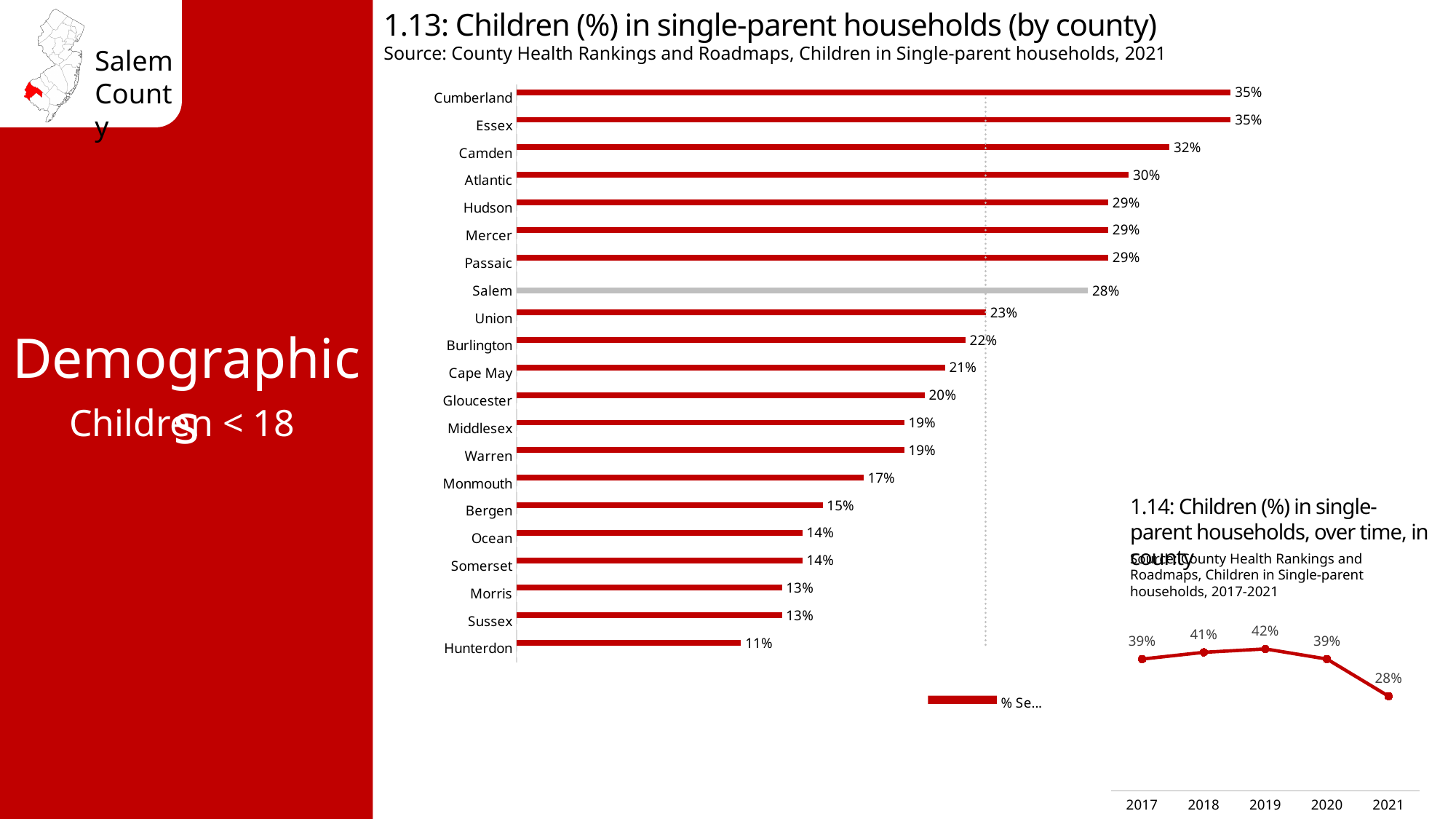
In chart 1.14 (Children (%) in single-parent households over time), what is the value for 2019? 42% In chart 1.14 (Children (%) in single-parent households over time), what is the difference between 2020 and 2021? 11% In chart 1.14 (Children (%) in single-parent households over time), which year has the lowest value? 2021 In chart 1.13 (Children (%) in single-parent households by county), what is the value for Gloucester? 20% In chart 1.13 (Children (%) in single-parent households by county), which county has the lowest value? Hunterdon In chart 1.13 (Children (%) in single-parent households by county), what is the difference between Cumberland and Hunterdon? 24% What kind of chart is chart 1.13 (Children (%) in single-parent households by county)? Bar chart In chart 1.13 (Children (%) in single-parent households by county), what is the value for Salem? 28% In chart 1.13 (Children (%) in single-parent households by county), which is larger, Camden or Atlantic? Camden In chart 1.13 (Children (%) in single-parent households by county), which county's bar is coloured grey instead of red? Salem What kind of chart is chart 1.14 (Children (%) in single-parent households over time)? Line chart In chart 1.13 (Children (%) in single-parent households by county), how many counties are shown? 21